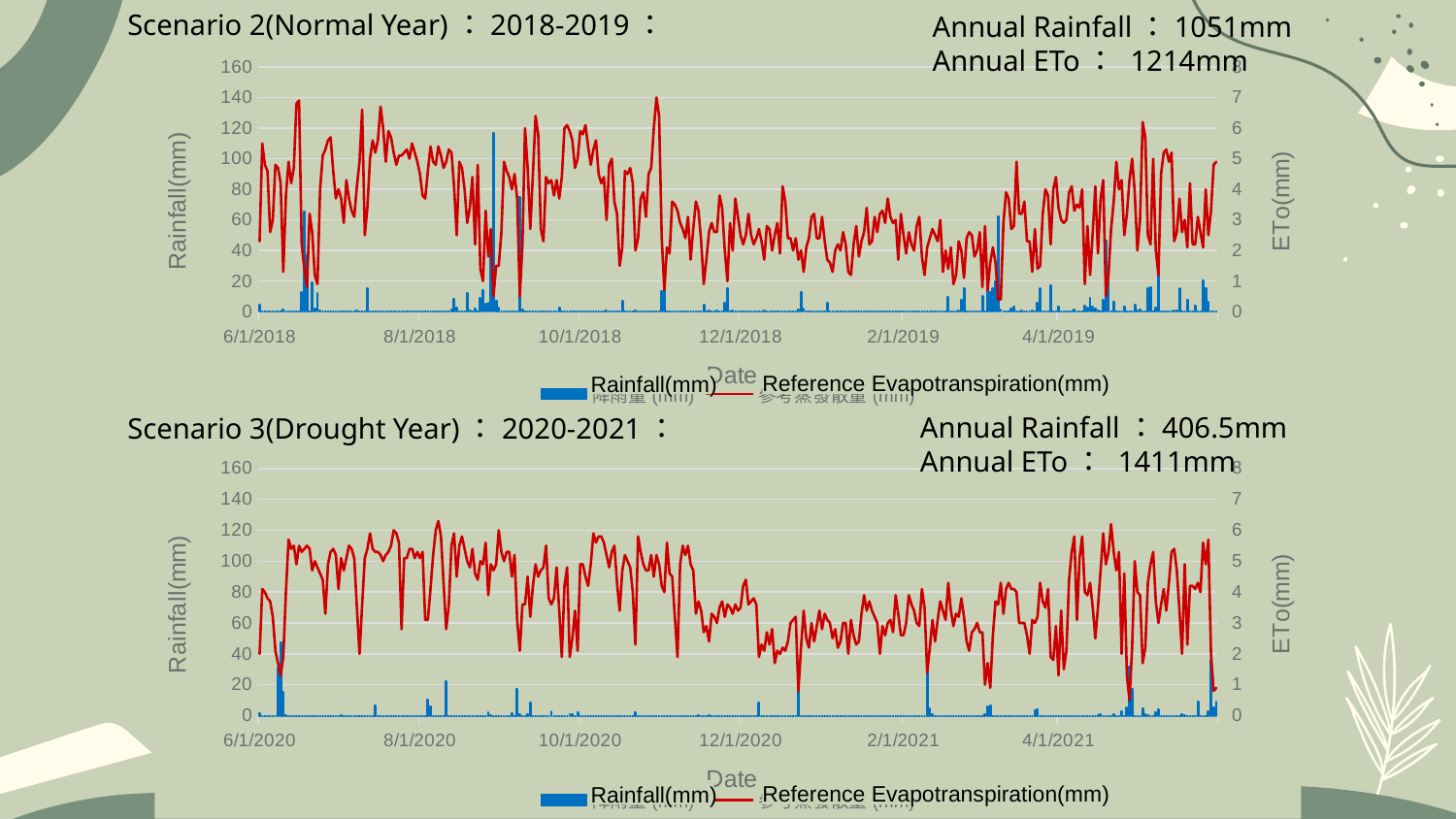
What is the difference between the annual rainfall of Scenario 2 (Normal Year) and Scenario 3 (Drought Year)? 644.5mm In the Scenario 2 (Normal Year) chart, does the Reference Evapotranspiration line generally rise or fall between 8/1/2018 and 12/1/2018? fall How many series does the legend of the Scenario 3 (Drought Year) chart list? 2 In the Scenario 2 (Normal Year) chart, is the tallest rainfall bar (around 9/1/2018) greater or less than 100 mm? greater What is the difference between the annual ETo of Scenario 3 (Drought Year) and Scenario 2 (Normal Year)? 197mm Which scenario has the higher annual rainfall, Scenario 2 (Normal Year) or Scenario 3 (Drought Year)? Scenario 2 (Normal Year) What is the label of the right-hand vertical axis on the Scenario 3 (Drought Year) chart? ETo(mm) What kind of chart is the Scenario 2 (Normal Year) chart? A combined bar and line chart What is the annual ETo stated for Scenario 3 (Drought Year) 2020-2021? 1411mm What is the annual rainfall stated for Scenario 2 (Normal Year) 2018-2019? 1051mm What are the two legend entries on the Scenario 2 (Normal Year) chart? Rainfall(mm) and Reference Evapotranspiration(mm) How many date labels are shown on the x axis of the Scenario 3 (Drought Year) chart? 6